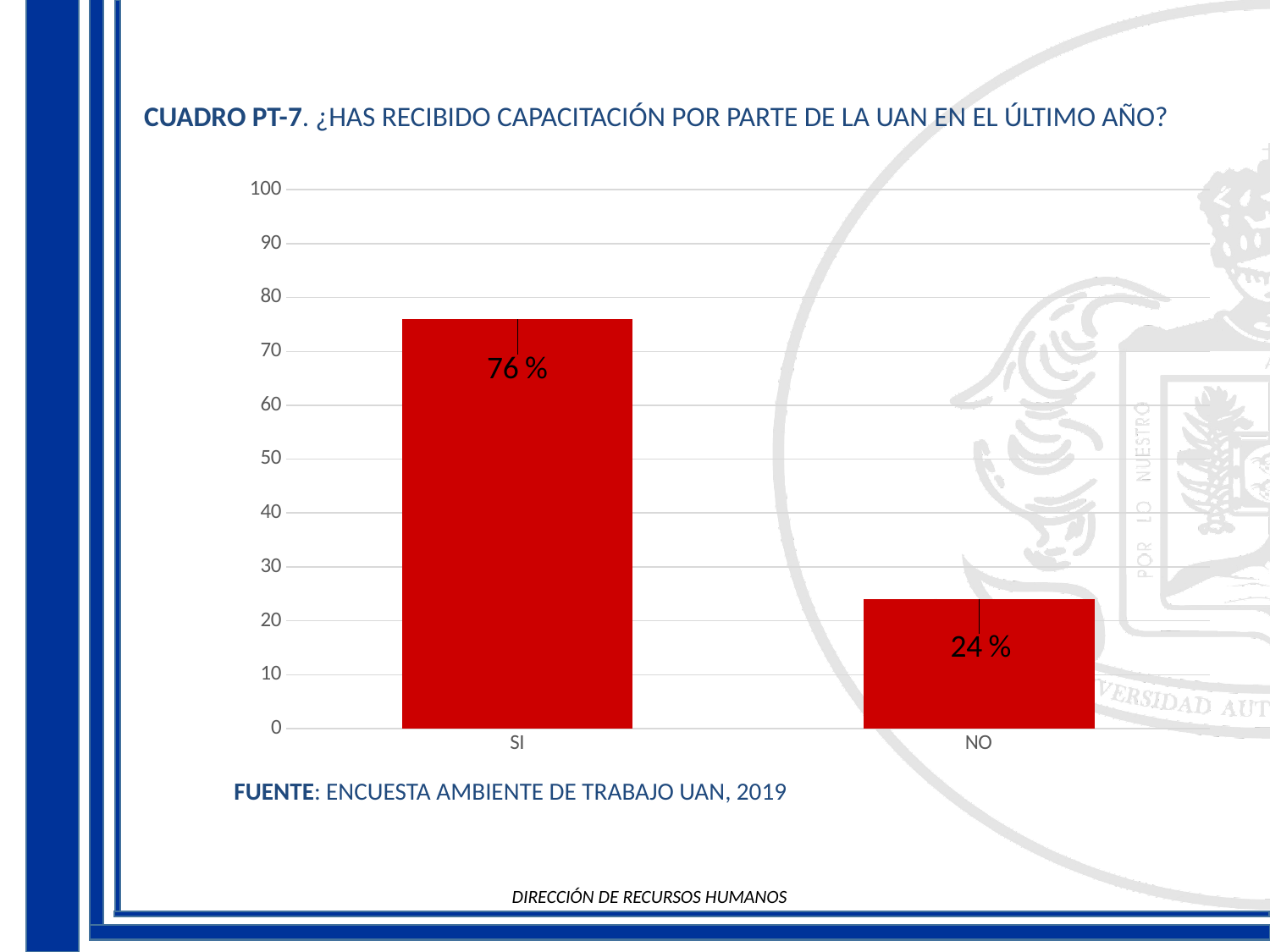
What is the difference between the values for SI and NO? 52 % What is the source cited below the chart? ENCUESTA AMBIENTE DE TRABAJO UAN, 2019 Which category has the highest value? SI What colour are the bars in the chart? red Is the value for SI greater or less than 70? greater Which is larger, the value for SI or the value for NO? SI Is the value for NO greater or less than 30? less What kind of chart is shown on the slide? bar chart Which category has the lowest value? NO How many categories are shown on the x axis? 2 What is the value for SI? 76 % What is the value for NO? 24 %